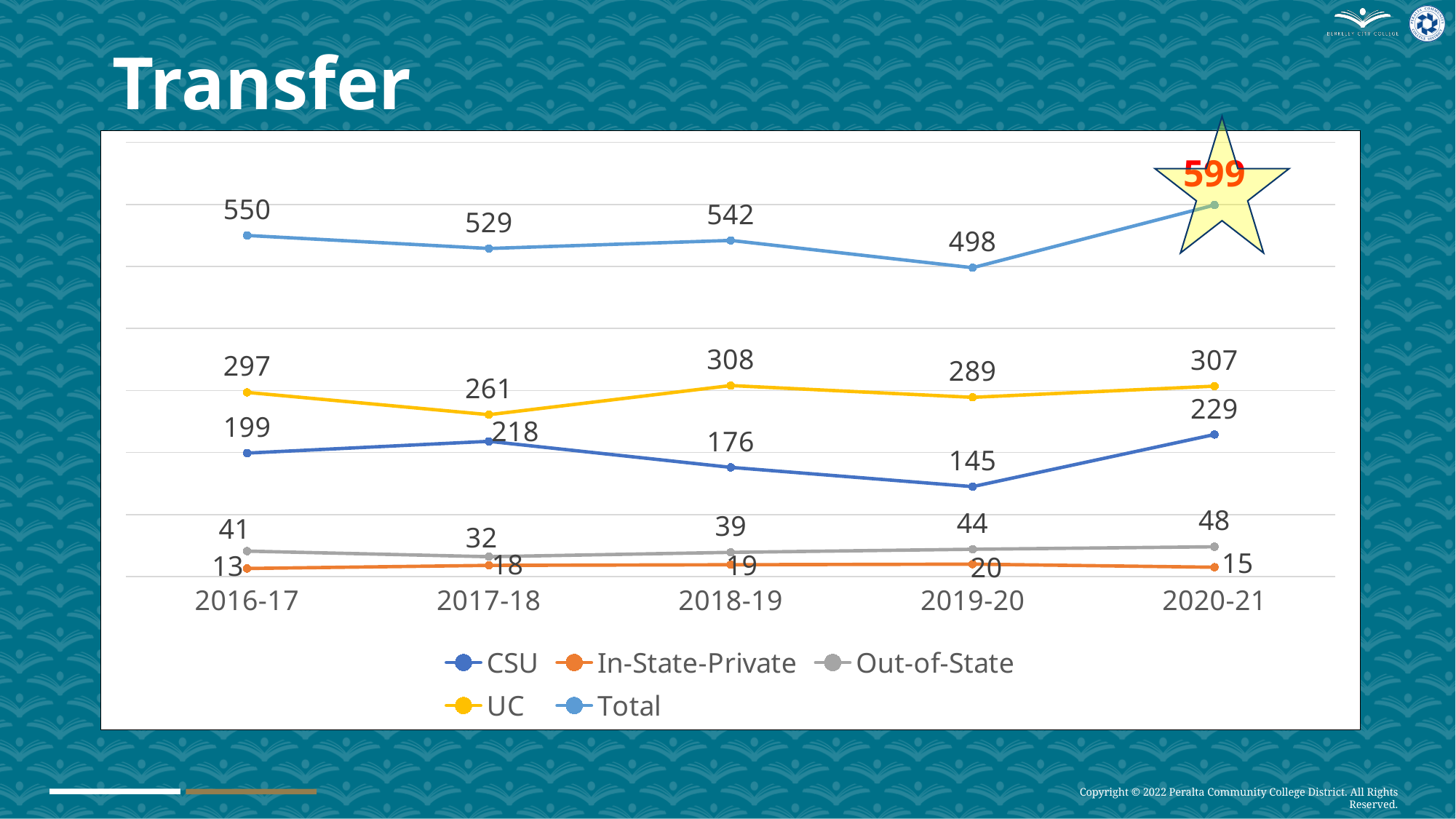
What is the difference between the Total in 2020-21 and the Total in 2019-20? 101 In which year is the CSU value highest? 2020-21 What is the In-State-Private value for 2016-17? 13 What is the UC value for 2018-19? 308 How many series does the legend list? 5 In which year is the Total lowest? 2019-20 What kind of chart is shown on the slide? line chart Which is larger in 2017-18, the UC value or the CSU value? UC What is the Total value for 2020-21? 599 Does the Out-of-State series rise or fall from 2017-18 to 2020-21? rise What is the CSU value for 2019-20? 145 How many years are shown on the x axis? 5